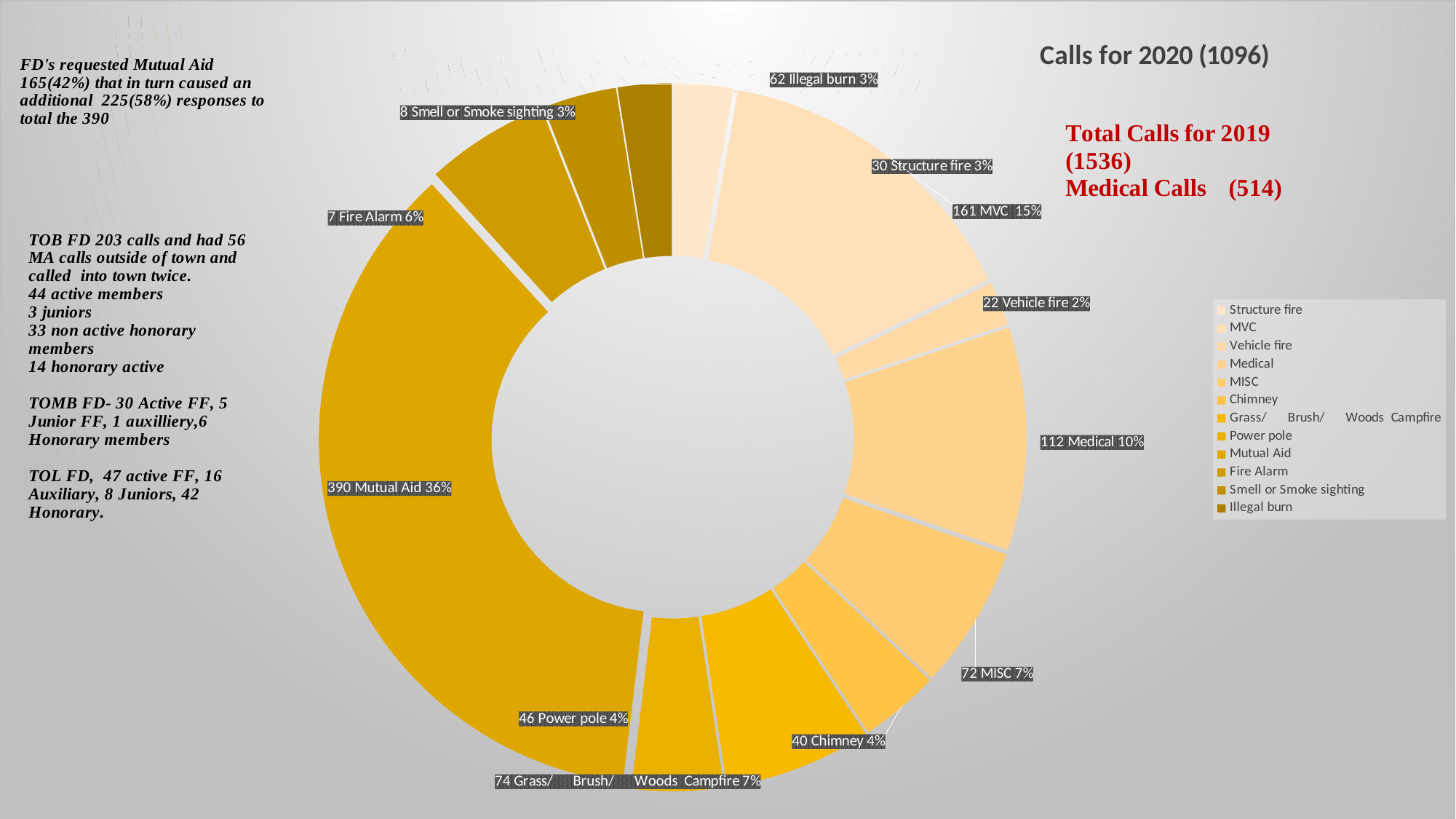
How many categories does the legend list? 12 Which is larger, the value for MVC or the value for Medical? MVC What is the difference between the MVC value and the Medical value? 49 What value is shown for Grass/ Brush/ Woods Campfire? 74 Which category has the largest slice? Mutual Aid What kind of chart is shown on the slide? doughnut chart What value is shown for Medical? 112 What is the title of the chart? Calls for 2020 (1096) What value is shown for MVC? 161 Which category has the smallest percentage shown? Vehicle fire What percentage is shown for Mutual Aid? 36% How many slices does the chart have? 12